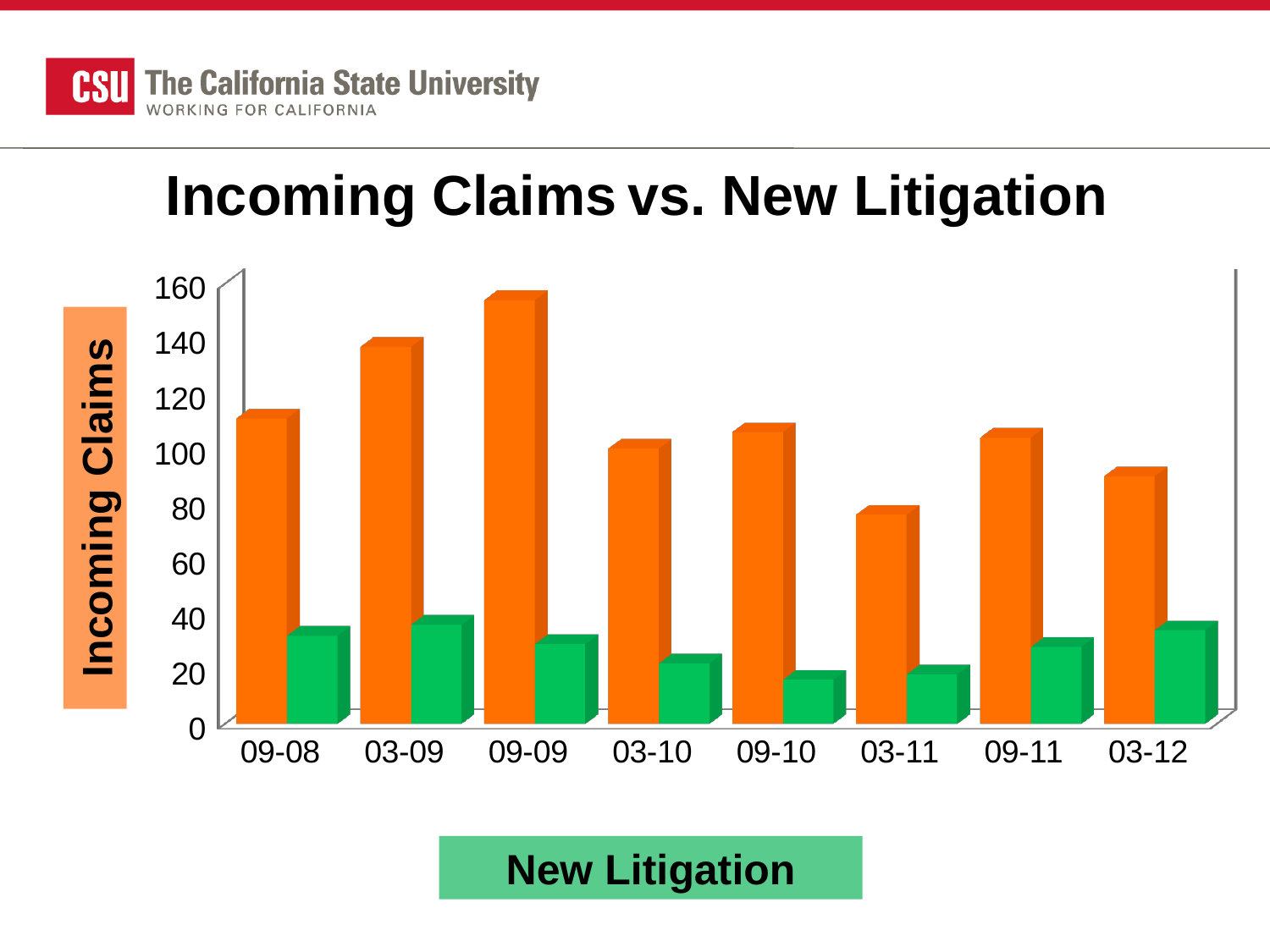
Is the value for New Litigation in 03-10 greater or less than 40? less Is the value for Incoming Claims in 03-11 greater or less than 100? less Which is larger in 09-09, Incoming Claims or New Litigation? Incoming Claims Which period has the lowest value for Incoming Claims? 03-11 Which period has the highest value for Incoming Claims? 09-09 Which is larger, Incoming Claims in 03-09 or Incoming Claims in 09-08? 03-09 Is the value for Incoming Claims in 09-09 greater or less than 140? greater How many series does the chart show? 2 How many time periods are shown along the x axis? 8 Do the Incoming Claims values rise or fall from 09-08 to 09-09? rise What kind of chart is shown on the slide? bar chart What is the title of the chart? Incoming Claims vs. New Litigation